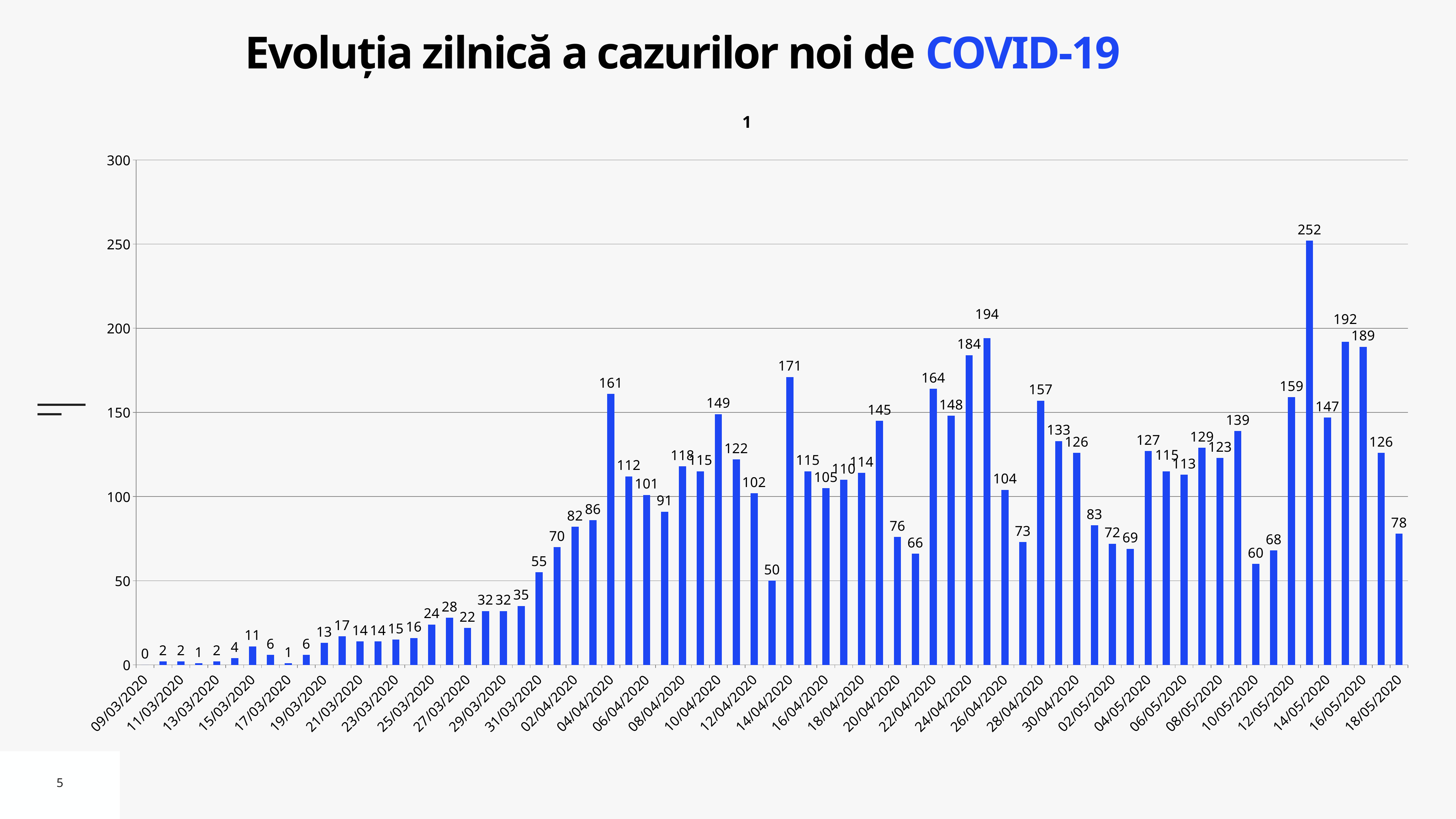
What is the value for 04/04/2020? 161 Do the values generally rise or fall from 09/03/2020 to 31/03/2020? rise What is the value for 14/04/2020? 171 Is the value for 10/05/2020 greater or less than 100? less What is the value for 18/05/2020? 78 Which date has the lowest value? 09/03/2020 What is the title of the slide? Evoluția zilnică a cazurilor noi de COVID-19 What is the highest value shown on the chart? 252 What is the difference between the values for 24/04/2020 and 22/04/2020? 20 Is the value for 12/05/2020 greater or less than 150? greater What kind of chart is shown on the slide? bar chart Which is larger, the value for 04/04/2020 or the value for 10/04/2020? 04/04/2020